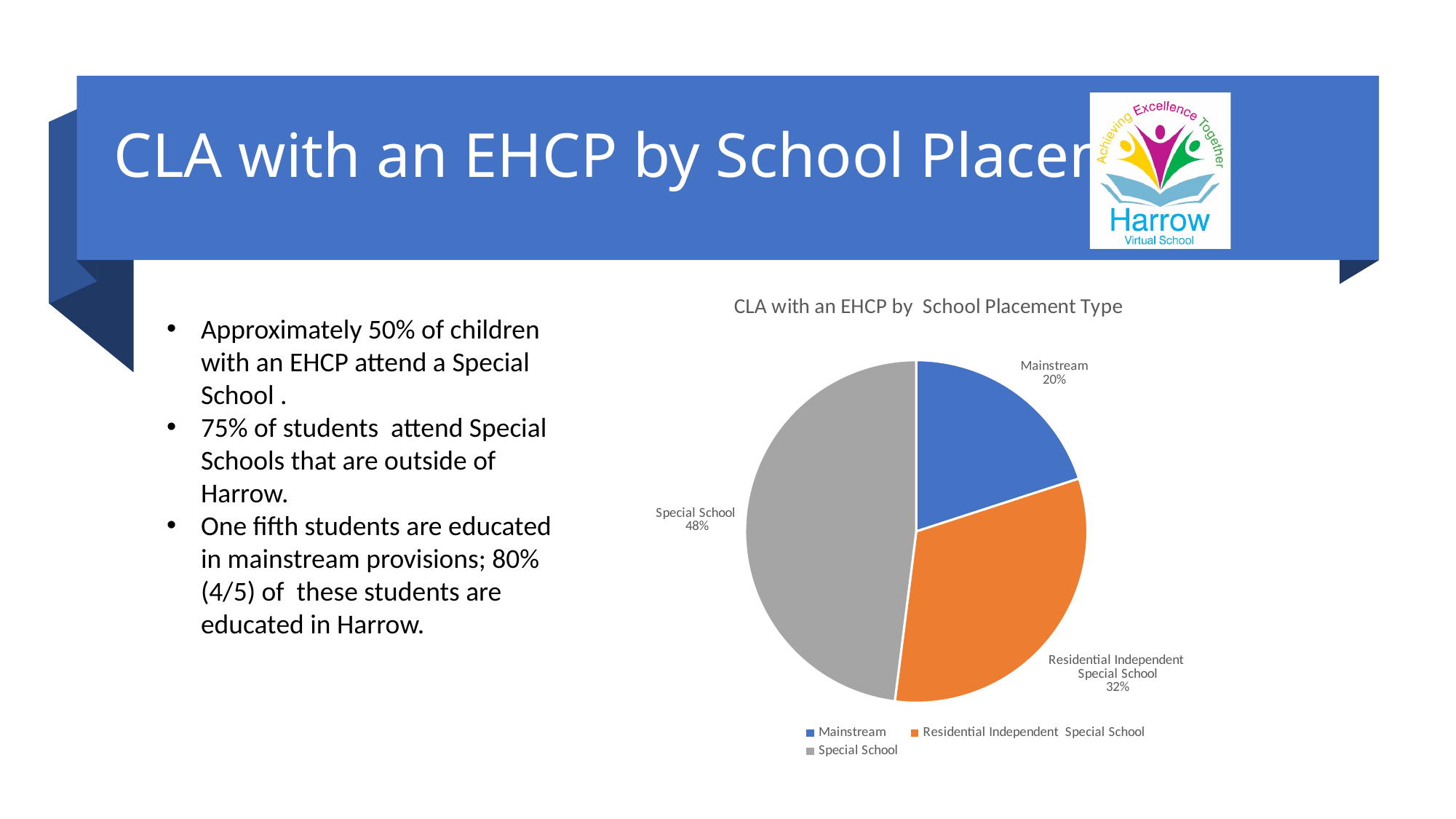
What is the title of the chart? CLA with an EHCP by School Placement Type What percentage of the pie is Mainstream? 20% What percentage of the pie is Special School? 48% What colour is the Special School slice? Grey Which placement type has the smallest share of the pie? Mainstream How many entries does the legend list? 3 What percentage of the pie is Residential Independent Special School? 32% Which placement type has the largest share of the pie? Special School What type of chart is shown on the slide? Pie chart What is the difference in percentage points between Special School and Mainstream? 28 Which is larger, the share for Residential Independent Special School or the share for Mainstream? Residential Independent Special School How many slices does the pie chart have? 3